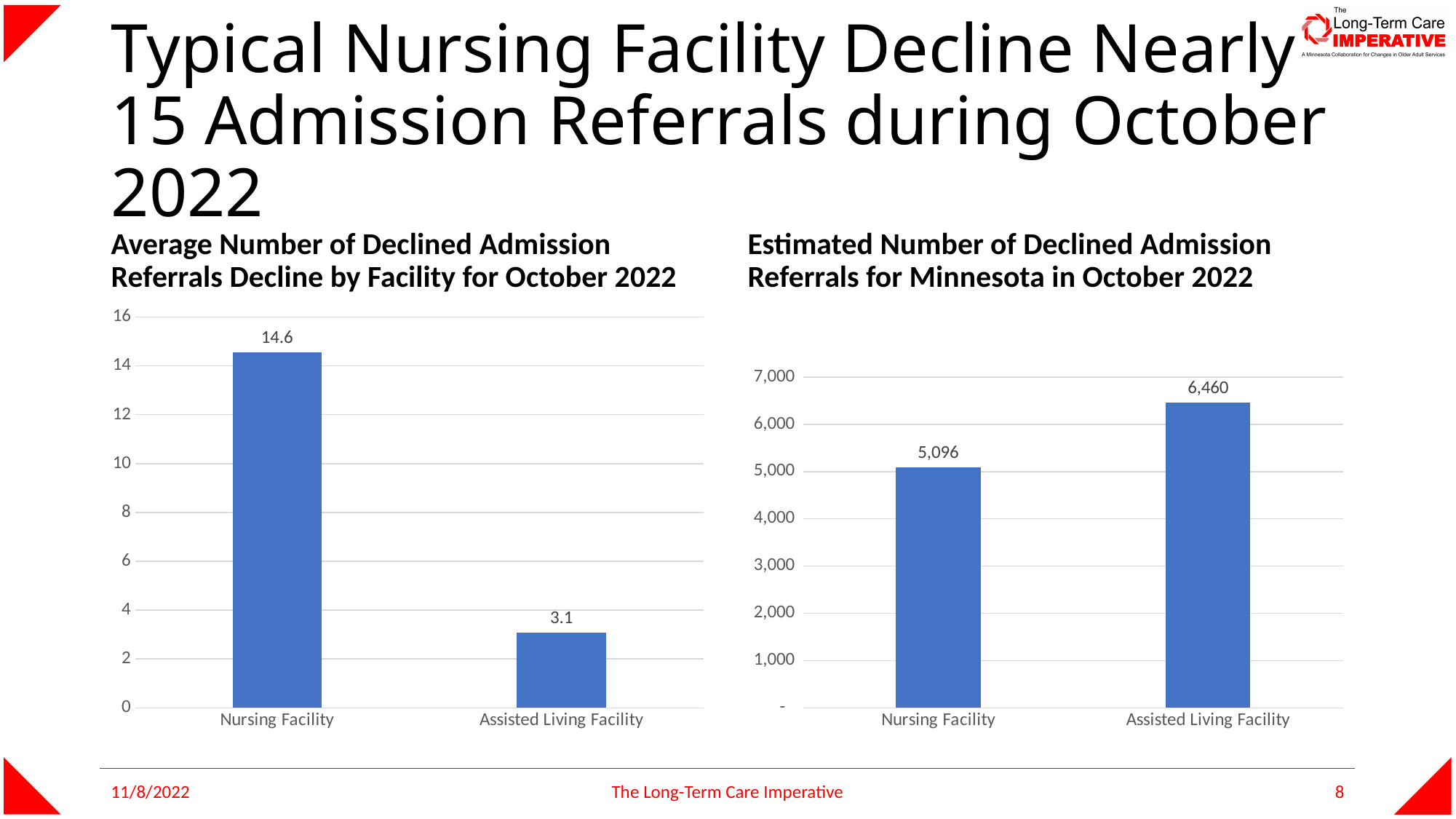
In the left chart, what is the difference between the Nursing Facility and Assisted Living Facility values? 11.5 In the right chart, what is the difference between the Assisted Living Facility and Nursing Facility values? 1,364 In the left chart (Average Number of Declined Admission Referrals Decline by Facility for October 2022), what is the value for Nursing Facility? 14.6 In the right chart, which is larger: Nursing Facility or Assisted Living Facility? Assisted Living Facility How many categories are shown in the right chart? 2 What kind of chart is the left chart? Bar chart In the right chart (Estimated Number of Declined Admission Referrals for Minnesota in October 2022), what is the value for Nursing Facility? 5,096 In the right chart (Estimated Number of Declined Admission Referrals for Minnesota in October 2022), what is the value for Assisted Living Facility? 6,460 In the right chart, which category has the lowest value? Nursing Facility In the left chart (Average Number of Declined Admission Referrals Decline by Facility for October 2022), what is the value for Assisted Living Facility? 3.1 In the left chart, is the value for Nursing Facility greater or less than 14? greater In the left chart, which category has the highest value? Nursing Facility